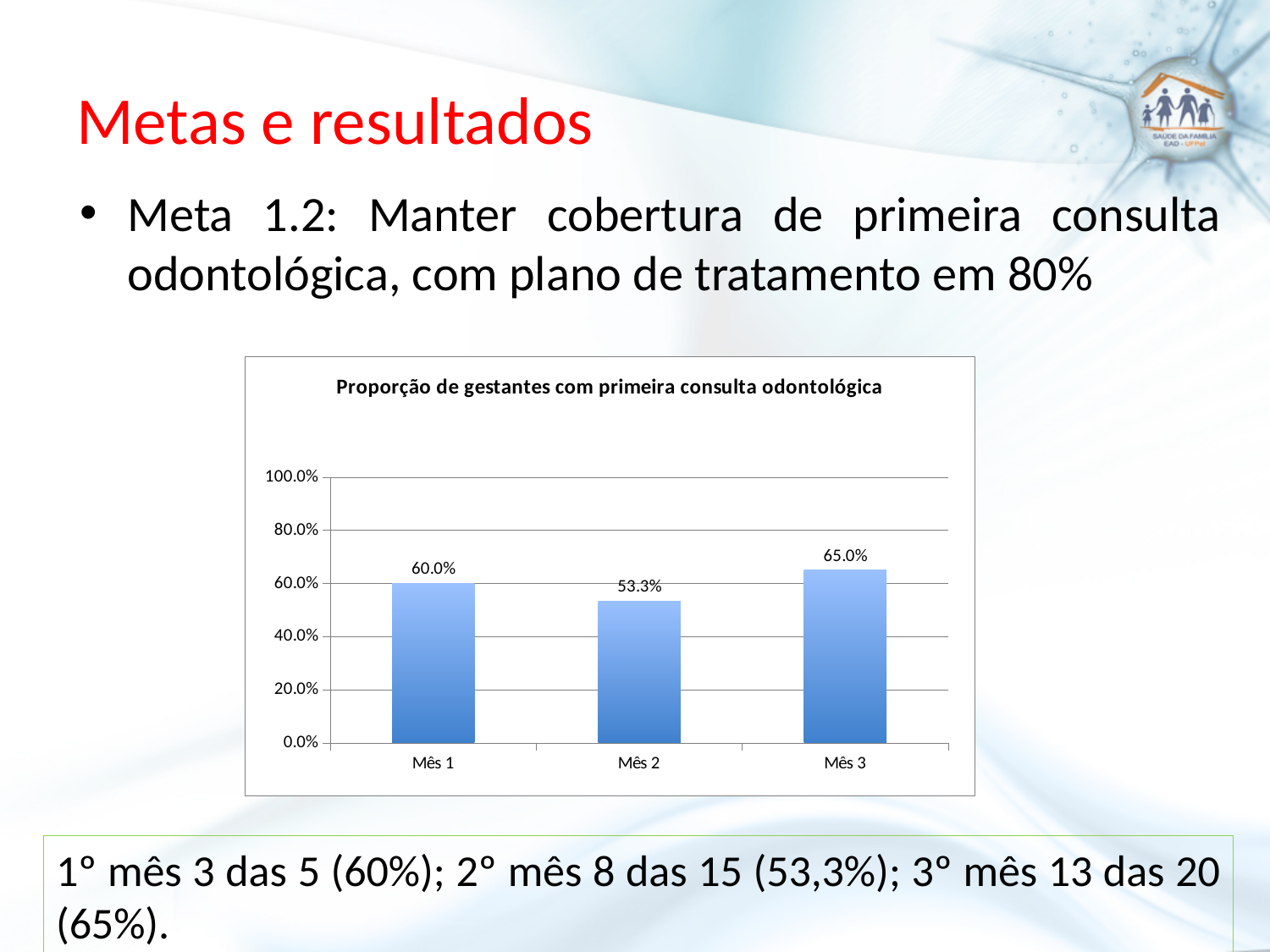
What is the difference between the values for Mês 1 and Mês 2? 6.7% What kind of chart is shown? bar chart Which is larger, the value for Mês 1 or the value for Mês 2? Mês 1 What is the value for Mês 1? 60.0% Which month has the lowest proportion? Mês 2 Which month has the highest proportion? Mês 3 What is the value for Mês 3? 65.0% What is the title of the chart? Proporção de gestantes com primeira consulta odontológica How many months are shown on the x axis? 3 Is the value for Mês 3 greater or less than 80.0%? less What is the value for Mês 2? 53.3% What is the difference between the values for Mês 3 and Mês 1? 5.0%